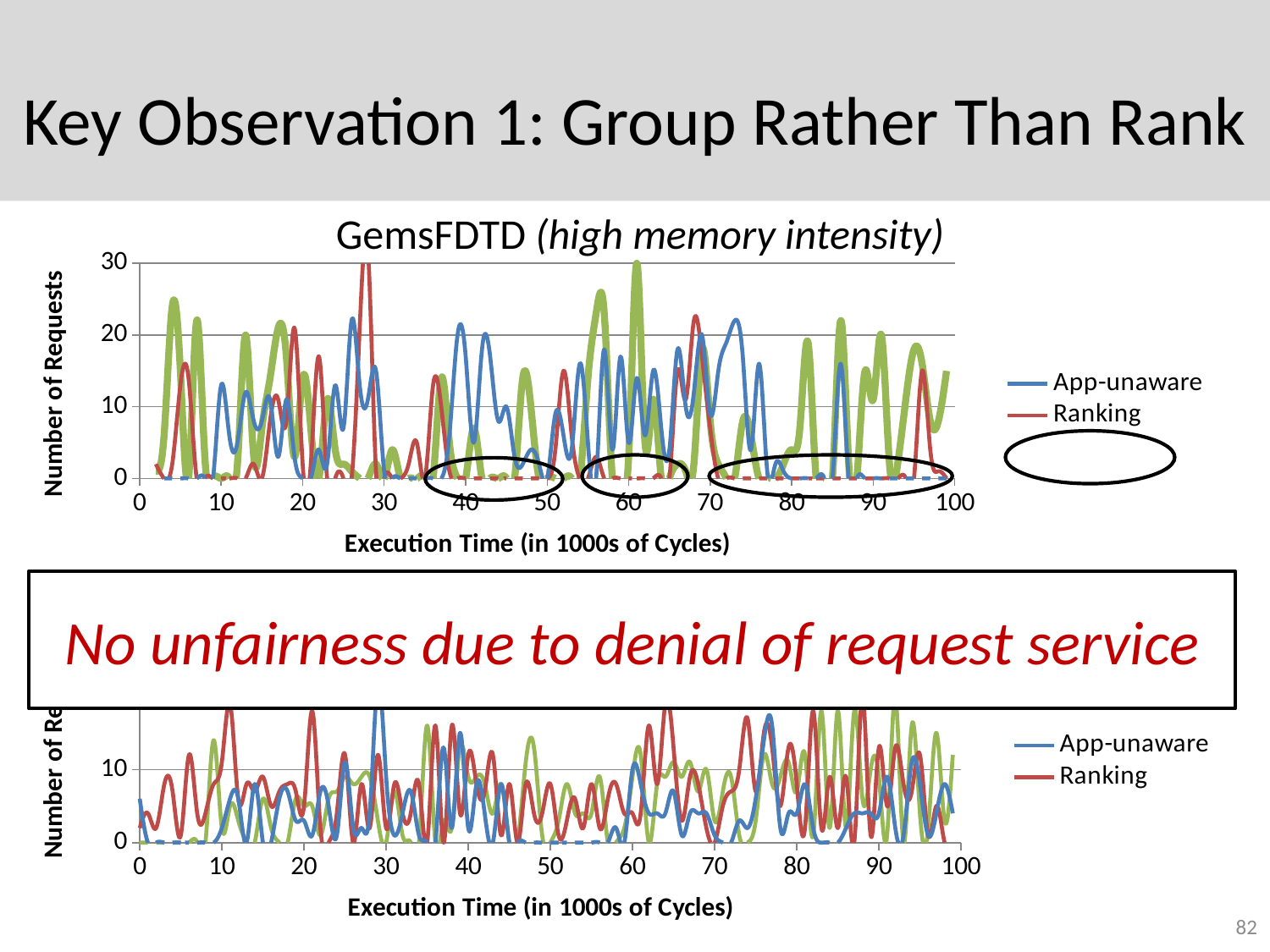
What kind of chart is the bottom chart? line chart In the top chart, what is the label of the y axis? Number of Requests What is the title of the top chart? GemsFDTD (high memory intensity) In the top chart, is the peak value of the Ranking series near execution time 28 greater or less than 20? greater What kind of chart is the top chart titled "GemsFDTD (high memory intensity)"? line chart In the top chart, what is the label of the x axis? Execution Time (in 1000s of Cycles) In the top chart, what is the highest value shown on the y axis? 30 In the top chart, which series is drawn in red according to the legend? Ranking In the top chart, what is the largest value shown on the x axis? 100 In the top chart, which series is drawn in blue according to the legend? App-unaware In the top chart, is the value of the App-unaware series at execution time 80 greater or less than 10? less